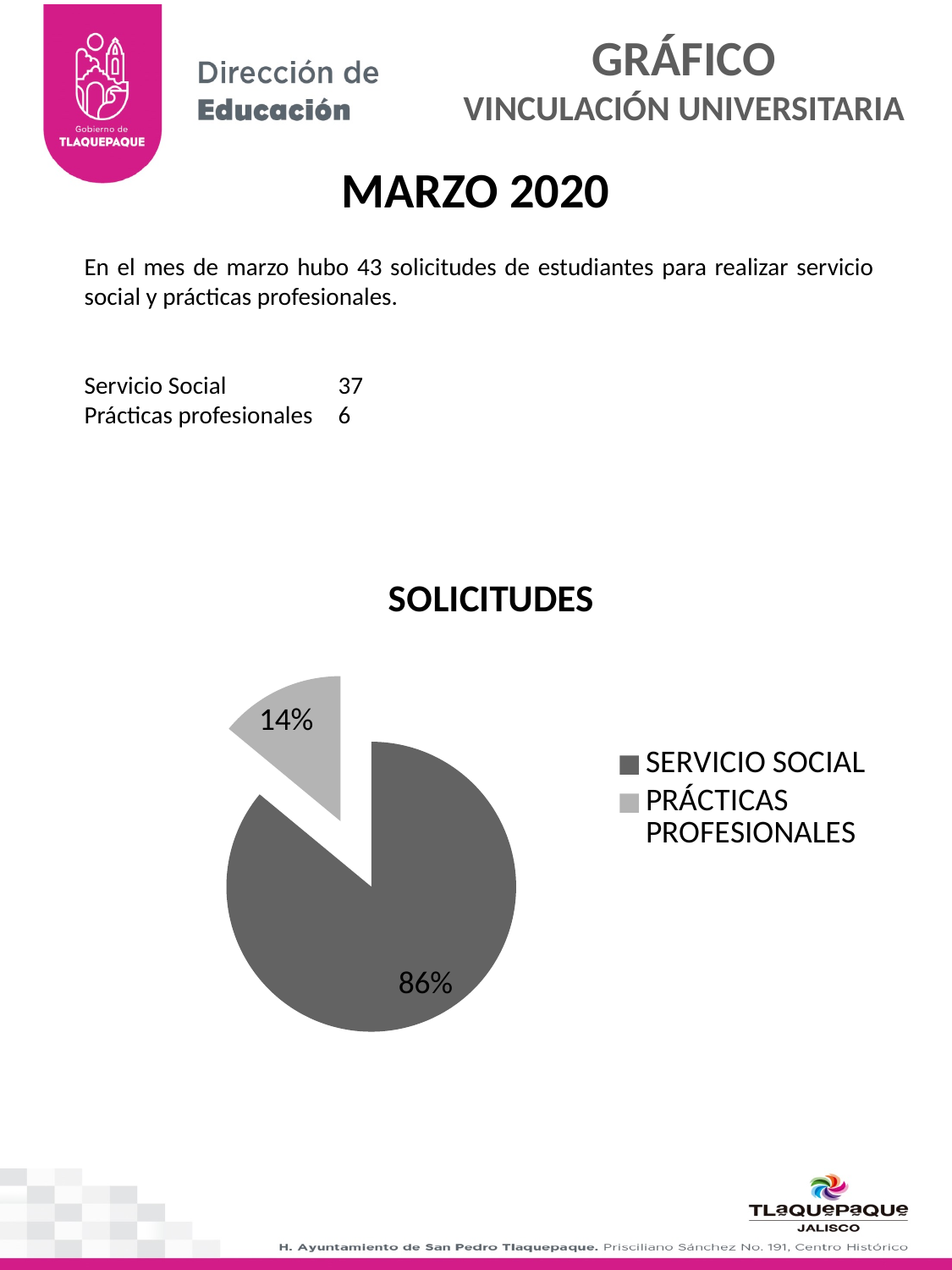
How many entries does the legend list? 2 What kind of chart is shown on the slide? pie chart Which category has the smallest slice of the pie? PRÁCTICAS PROFESIONALES What percentage of the pie does PRÁCTICAS PROFESIONALES represent? 14% Which slice is larger, SERVICIO SOCIAL or PRÁCTICAS PROFESIONALES? SERVICIO SOCIAL Which legend entry is shown in the lighter grey colour? PRÁCTICAS PROFESIONALES What is the title of the chart? SOLICITUDES Which category has the largest slice of the pie? SERVICIO SOCIAL What percentage of the pie does SERVICIO SOCIAL represent? 86% How many slices does the pie chart have? 2 What is the difference in percentage points between the SERVICIO SOCIAL slice and the PRÁCTICAS PROFESIONALES slice? 72